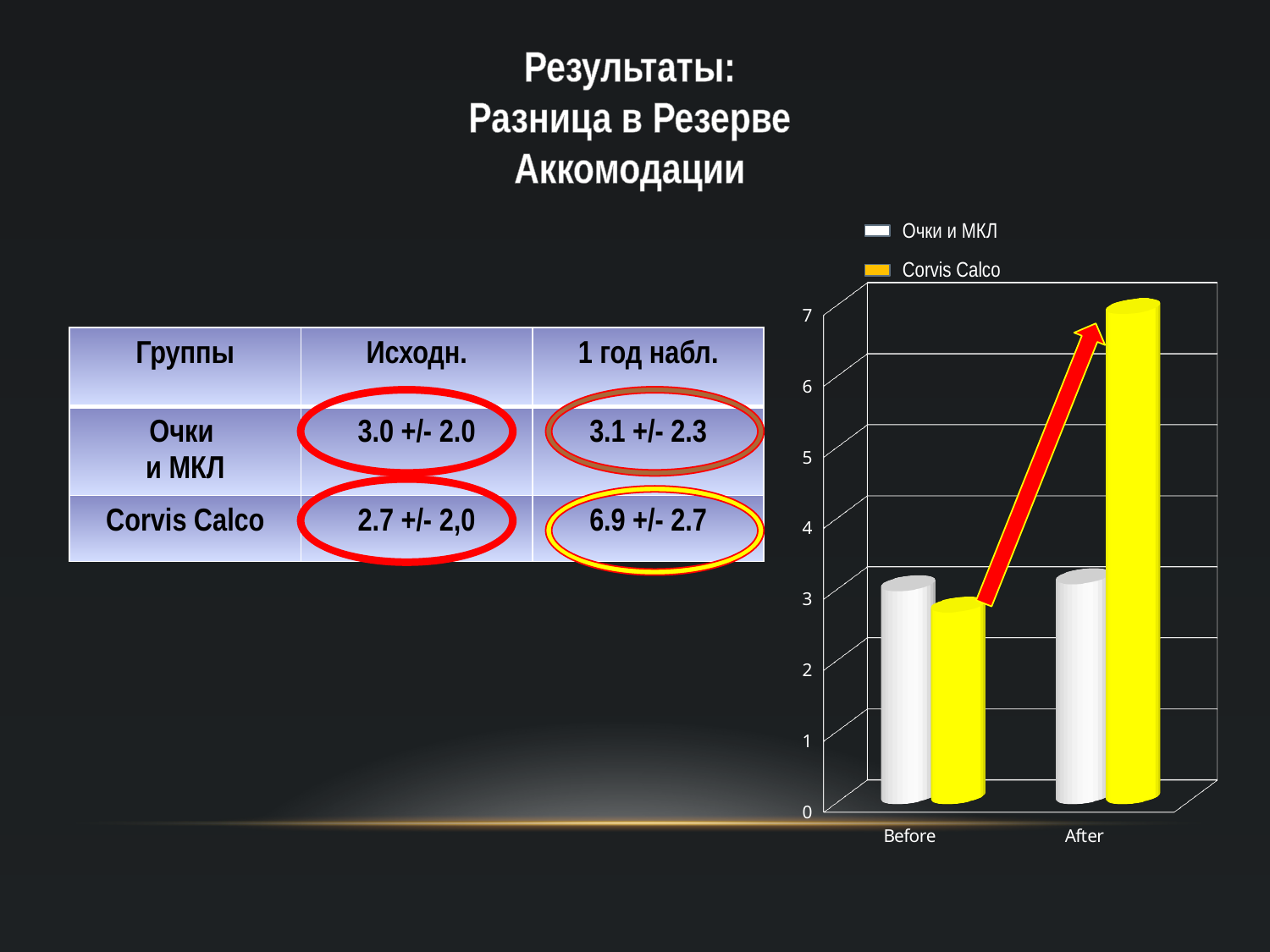
How many series does the chart legend list? 2 What colour are the bars for the Corvis Calco series? yellow Which series and category has the highest bar in the chart? Corvis Calco, After Is the value for Очки и МКЛ at After greater or less than 4? less Is the value for Corvis Calco at Before greater or less than 4? less What is the first series listed in the chart legend? Очки и МКЛ What kind of chart is shown on the slide? bar chart Is the value for Corvis Calco at After greater or less than 6? greater At After, which series has the larger value, Очки и МКЛ or Corvis Calco? Corvis Calco Does the value for Corvis Calco rise or fall from Before to After? rise How many categories are shown on the x axis of the chart? 2